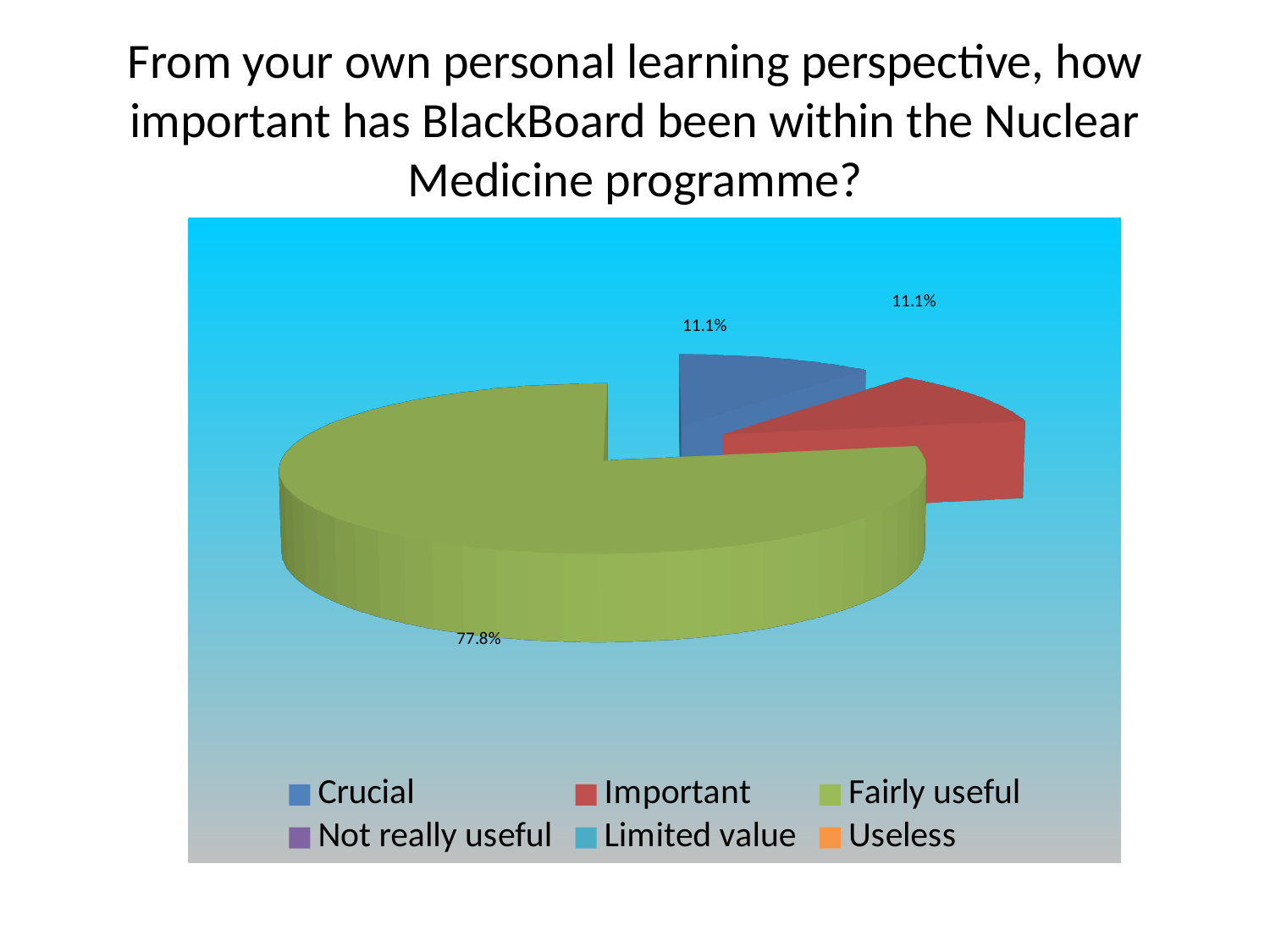
What kind of chart is shown on the slide? pie chart What colour is the "Fairly useful" slice? green How many slices are visible in the pie? 3 Which legend entry is shown in blue? Crucial Which category has the largest share of the pie? Fairly useful Which is larger, the share for "Fairly useful" or the share for "Important"? Fairly useful What is the difference between the "Fairly useful" share and the "Crucial" share? 66.7% What is the combined share of "Crucial" and "Important"? 22.2% What percentage of respondents rated BlackBoard as "Fairly useful"? 77.8% How many categories does the legend list? 6 What percentage of respondents rated BlackBoard as "Important"? 11.1% What percentage of respondents rated BlackBoard as "Crucial"? 11.1%